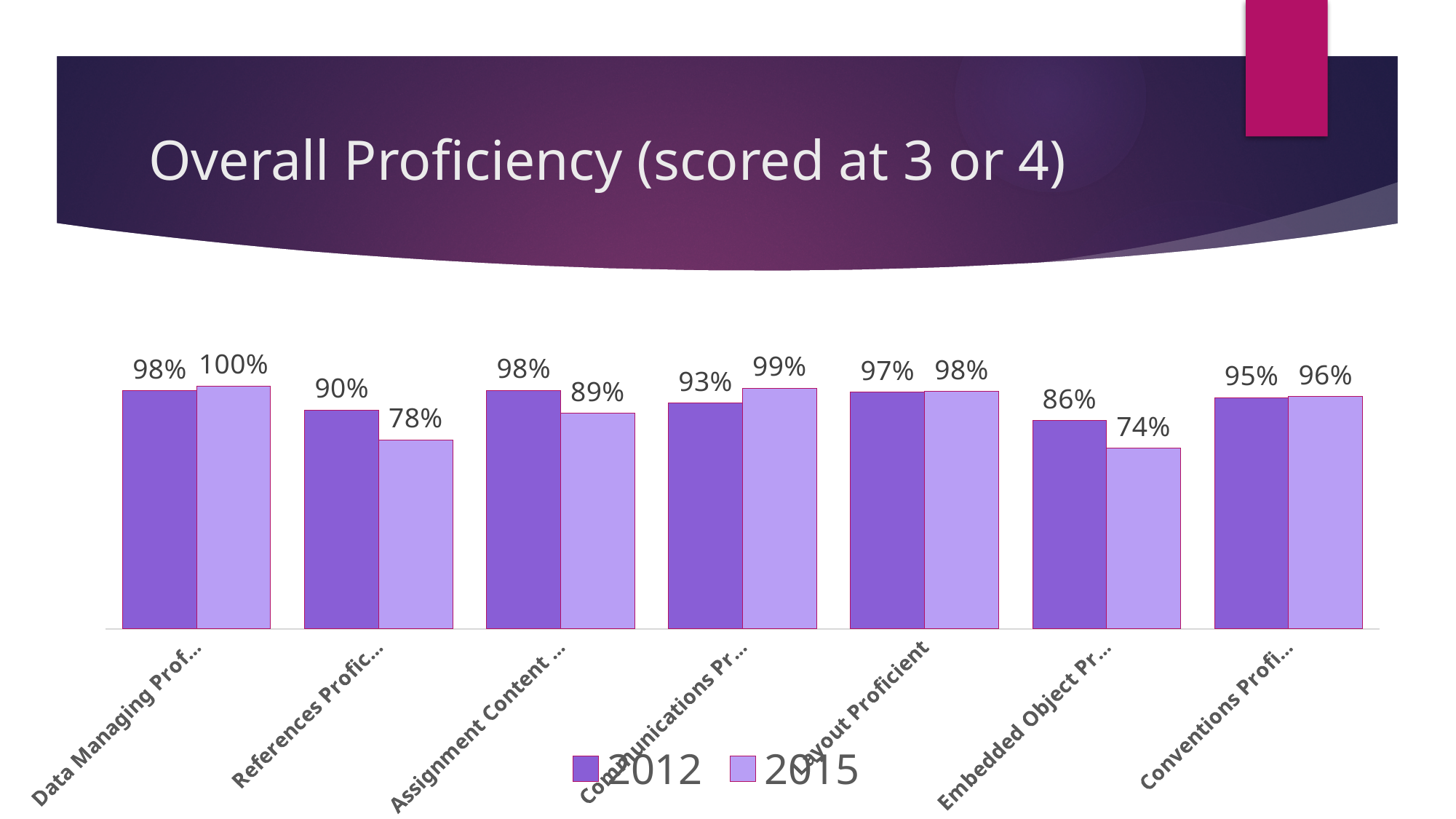
What kind of chart is shown on the slide? Bar chart How many categories are shown on the x axis? 7 Which category has the highest 2015 value? Data Managing What is the title of the slide? Overall Proficiency (scored at 3 or 4) What is the 2012 value for Layout Proficient? 97% Which is larger for the Communications category, the 2012 value or the 2015 value? 2015 What is the difference between the 2012 and 2015 values for the References category? 12% How many series does the legend list? 2 What is the 2012 value for the References category? 90% What is the 2015 value for the Embedded Object category? 74% What is the 2015 value for the Data Managing category? 100% Which category has the lowest 2015 value? Embedded Object